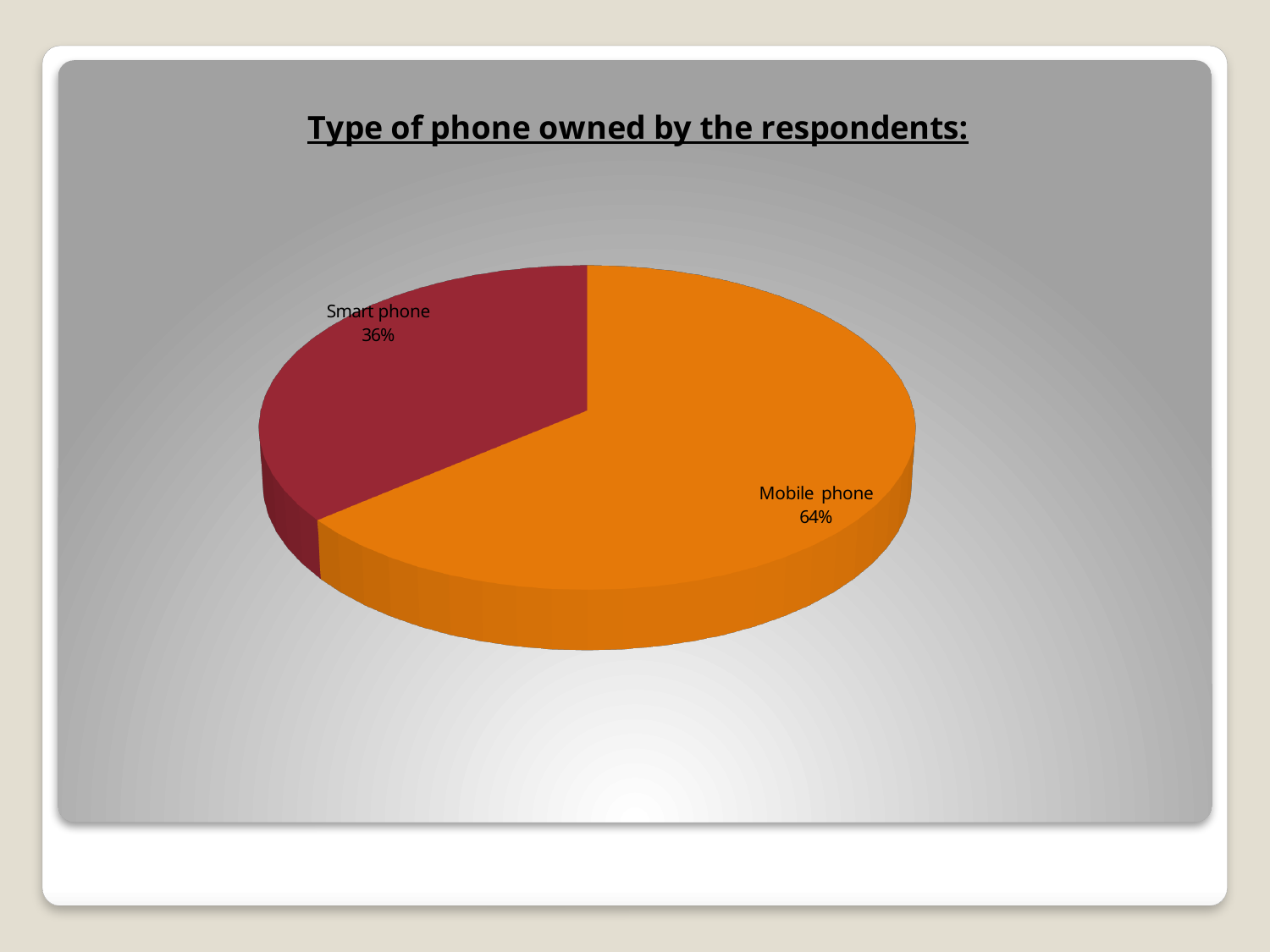
Which is larger: the share for mobile phone or the share for smart phone? Mobile phone What kind of chart is shown on the slide? Pie chart What colour is the slice for smart phone? Dark red Which type of phone has the largest share of respondents? Mobile phone Which type of phone has the smallest share of respondents? Smart phone How many categories are shown in the pie chart? 2 What is the title of the chart? Type of phone owned by the respondents: What is the combined share of the mobile phone and smart phone slices? 100% What share of respondents own a mobile phone? 64% What share of respondents own a smart phone? 36% What is the difference in percentage points between the mobile phone share and the smart phone share? 28